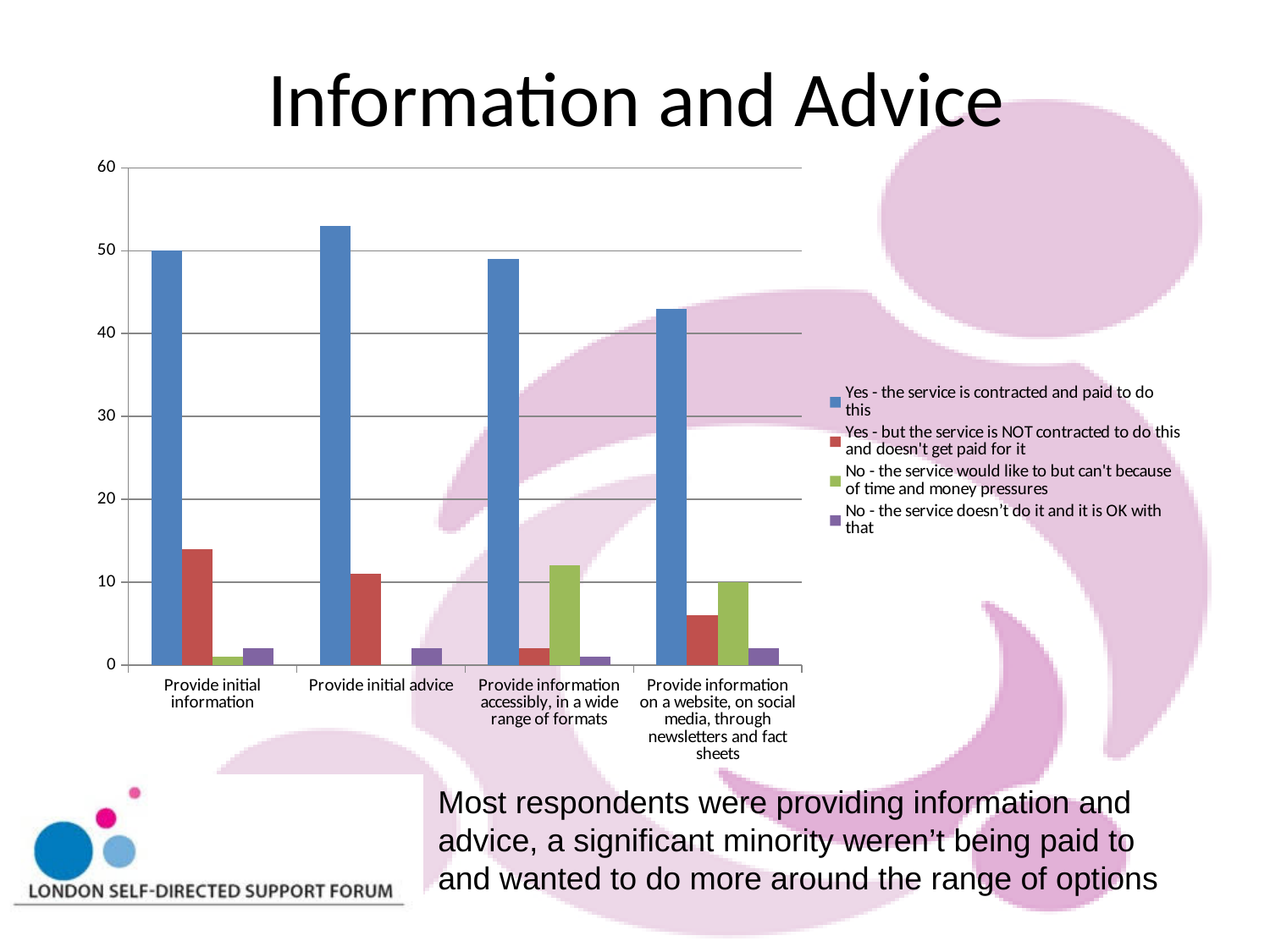
What is the title of the slide containing the chart? Information and Advice Is the value for 'Yes - the service is contracted and paid to do this' in the 'Provide initial advice' category greater or less than 50? greater Is the value for 'Yes - but the service is NOT contracted to do this and doesn't get paid for it' in the 'Provide initial information' category greater or less than 10? greater Is the value for 'Yes - the service is contracted and paid to do this' in the 'Provide information on a website, on social media, through newsletters and fact sheets' category greater or less than 50? less Which category has the tallest bar for 'Yes - the service is contracted and paid to do this'? Provide initial advice How many categories are shown along the x axis of the chart? 4 What kind of chart is shown on the slide? bar chart In the 'Provide initial information' category, which is larger: the 'Yes - but the service is NOT contracted to do this and doesn't get paid for it' bar or the 'No - the service would like to but can't because of time and money pressures' bar? Yes - but the service is NOT contracted to do this and doesn't get paid for it Which category has the shortest bar for 'Yes - the service is contracted and paid to do this'? Provide information on a website, on social media, through newsletters and fact sheets In the 'Provide information accessibly, in a wide range of formats' category, which is larger: the 'No - the service would like to but can't because of time and money pressures' bar or the 'Yes - but the service is NOT contracted to do this and doesn't get paid for it' bar? No - the service would like to but can't because of time and money pressures How many series does the chart's legend list? 4